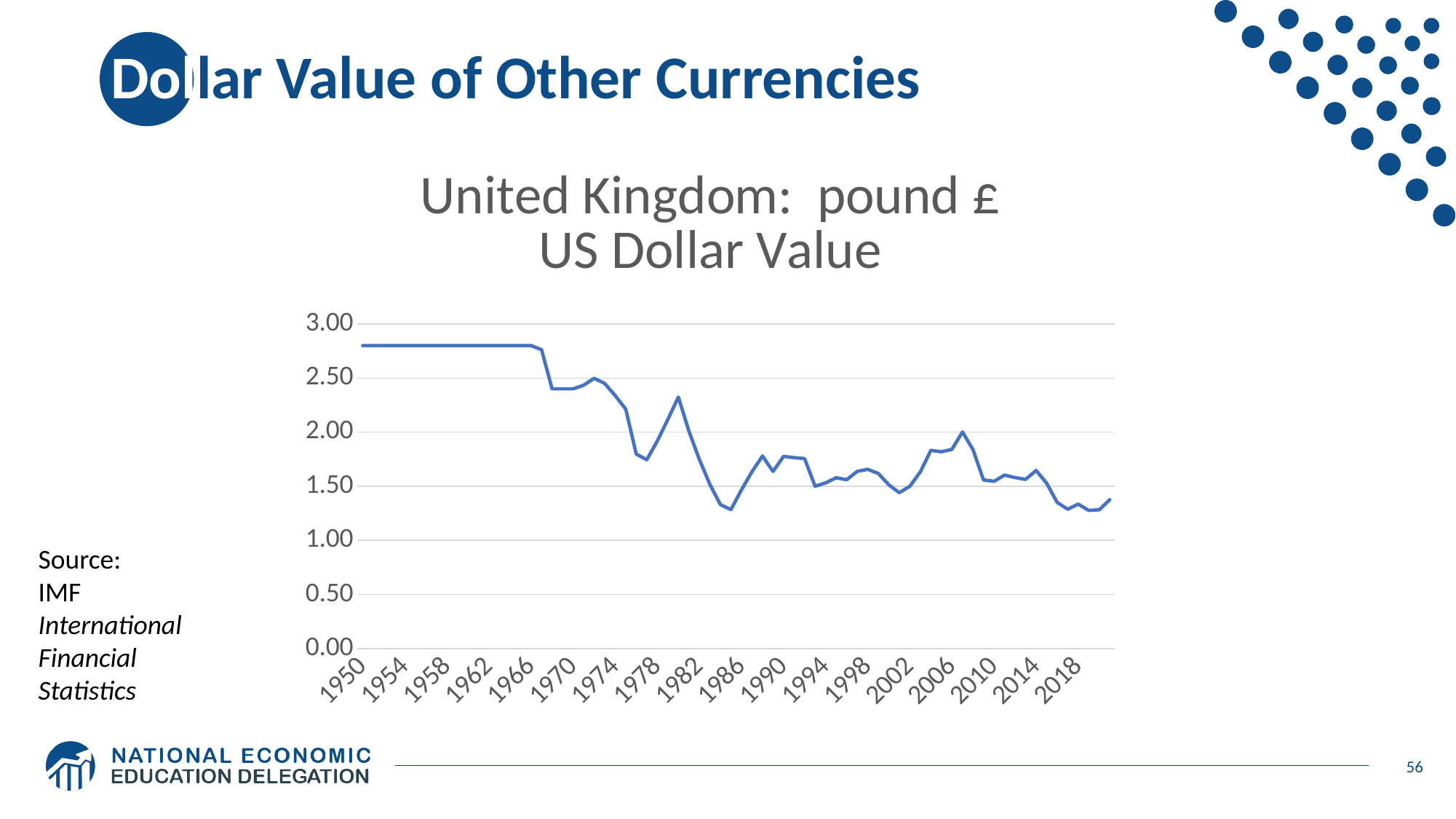
What kind of chart is shown on the slide? line chart What is the highest value shown on the vertical axis? 3.00 Which is larger, the value for 1970 or the value for 1986? 1970 What is the title of the chart? United Kingdom: pound £ US Dollar Value Which is larger, the value for 1950 or the value for 2018? 1950 Overall, does the US dollar value of the pound rise or fall from 1950 to 2018? fall Is the value for 2006 greater or less than 2.00? less Is the value for 1950 greater or less than 2.50? greater Is the value for 2018 greater or less than 1.50? less